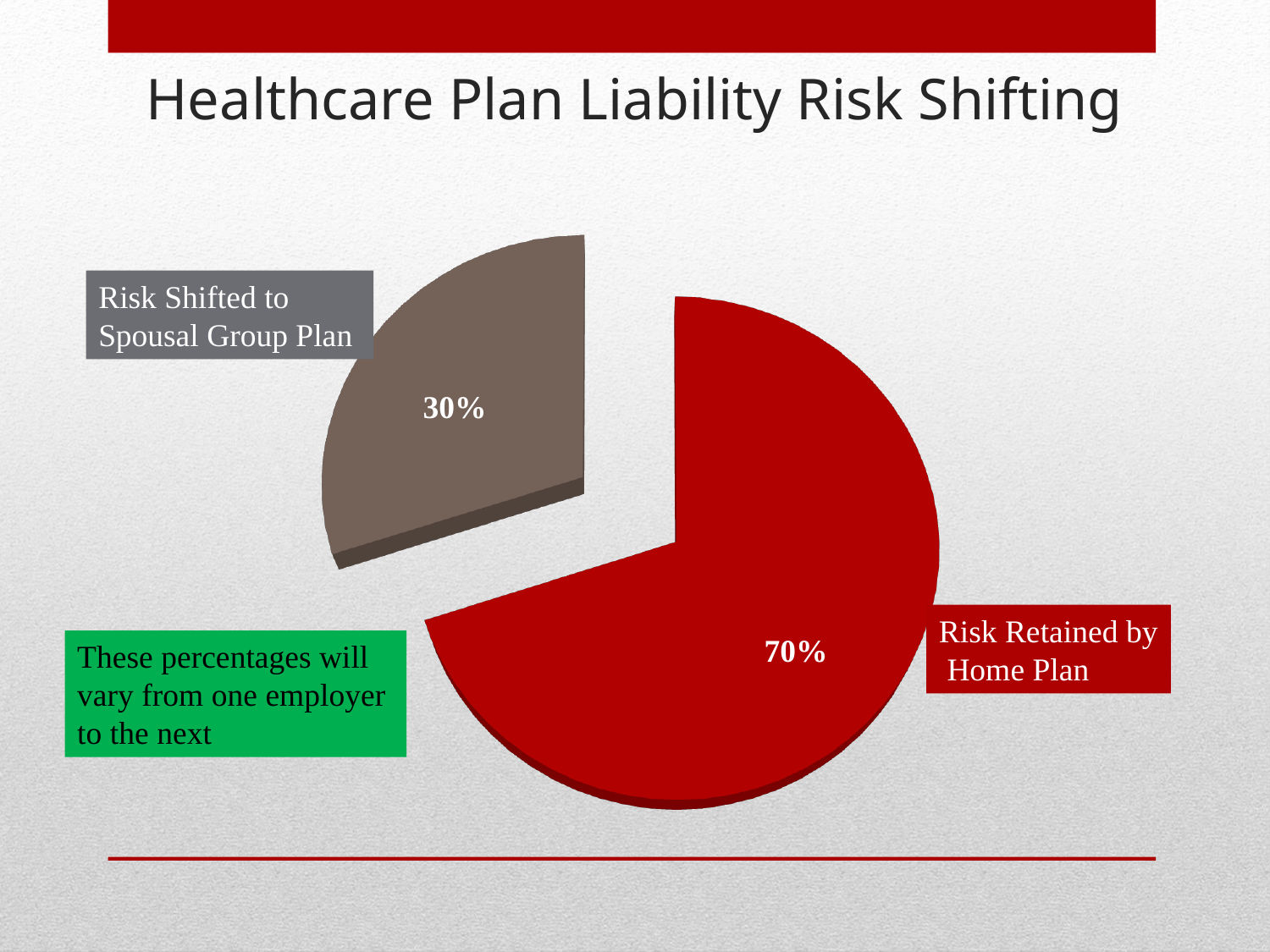
What share of the pie is labelled Risk Retained by Home Plan? 70% Which slice of the pie is the largest? Risk Retained by Home Plan What kind of chart is shown on the slide? pie chart Which slice of the pie is the smallest? Risk Shifted to Spousal Group Plan What is the title of the slide containing the pie chart? Healthcare Plan Liability Risk Shifting What colour is the Risk Retained by Home Plan slice? red Is the share for Risk Shifted to Spousal Group Plan greater or less than 50%? less Which is larger: the Risk Retained by Home Plan slice or the Risk Shifted to Spousal Group Plan slice? Risk Retained by Home Plan What share of the pie is labelled Risk Shifted to Spousal Group Plan? 30% How many slices does the pie chart have? 2 What is the difference in percentage points between the Risk Retained by Home Plan slice and the Risk Shifted to Spousal Group Plan slice? 40%